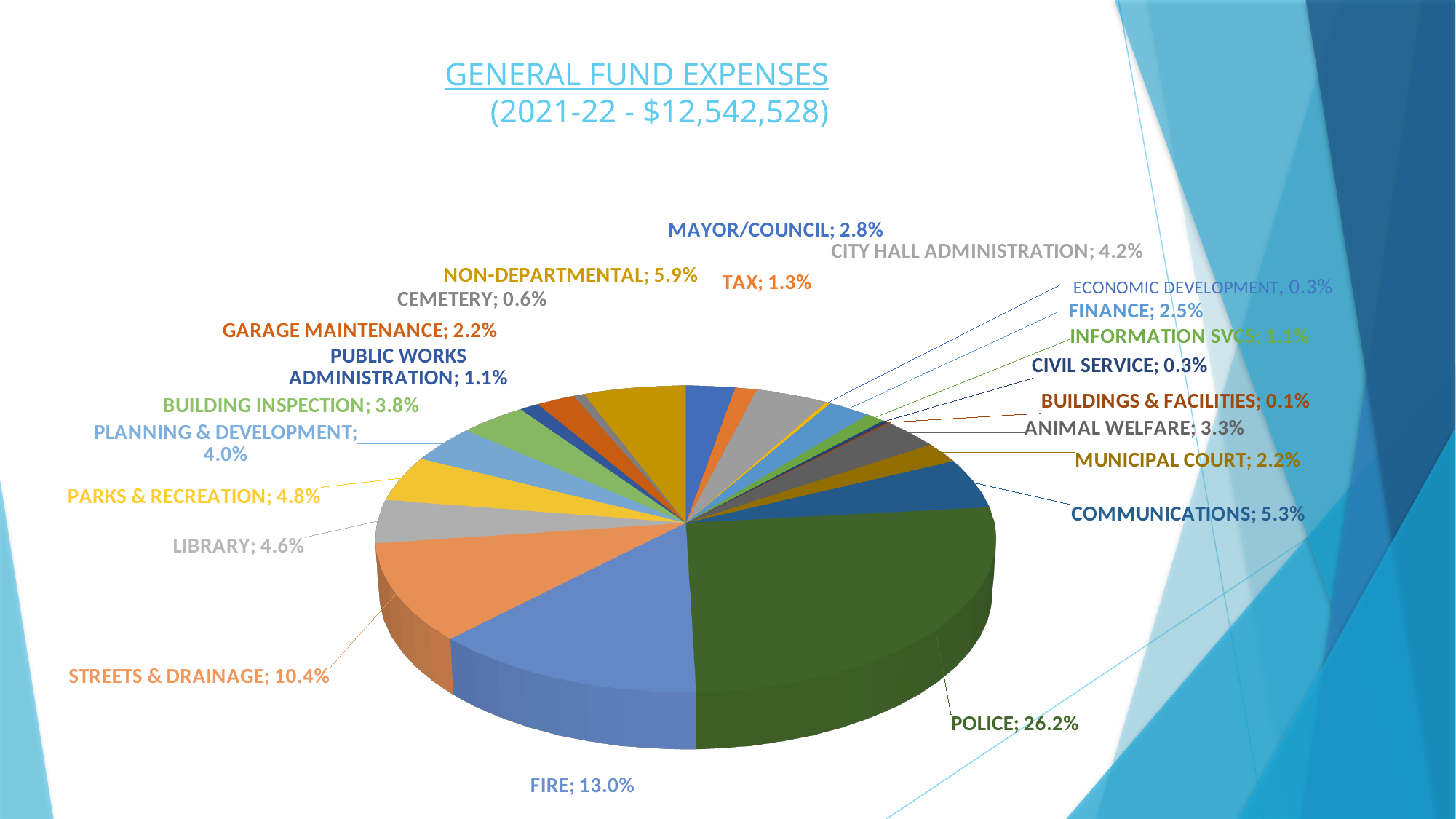
Which is larger, Non-Departmental or City Hall Administration? Non-Departmental What is the difference in percentage points between Police and Fire? 13.2 Which category has the smallest share of general fund expenses? Buildings & Facilities What percentage of expenses is Fire? 13.0% How many categories are shown in the pie chart? 22 Which is larger, Library or Parks & Recreation? Parks & Recreation What percentage is shown for Communications? 5.3% What total dollar amount is given in the chart title for 2021-22? $12,542,528 What kind of chart is shown on the slide? Pie chart What share of general fund expenses goes to Police? 26.2% Which category has the largest share of general fund expenses? Police What is the share for Streets & Drainage? 10.4%